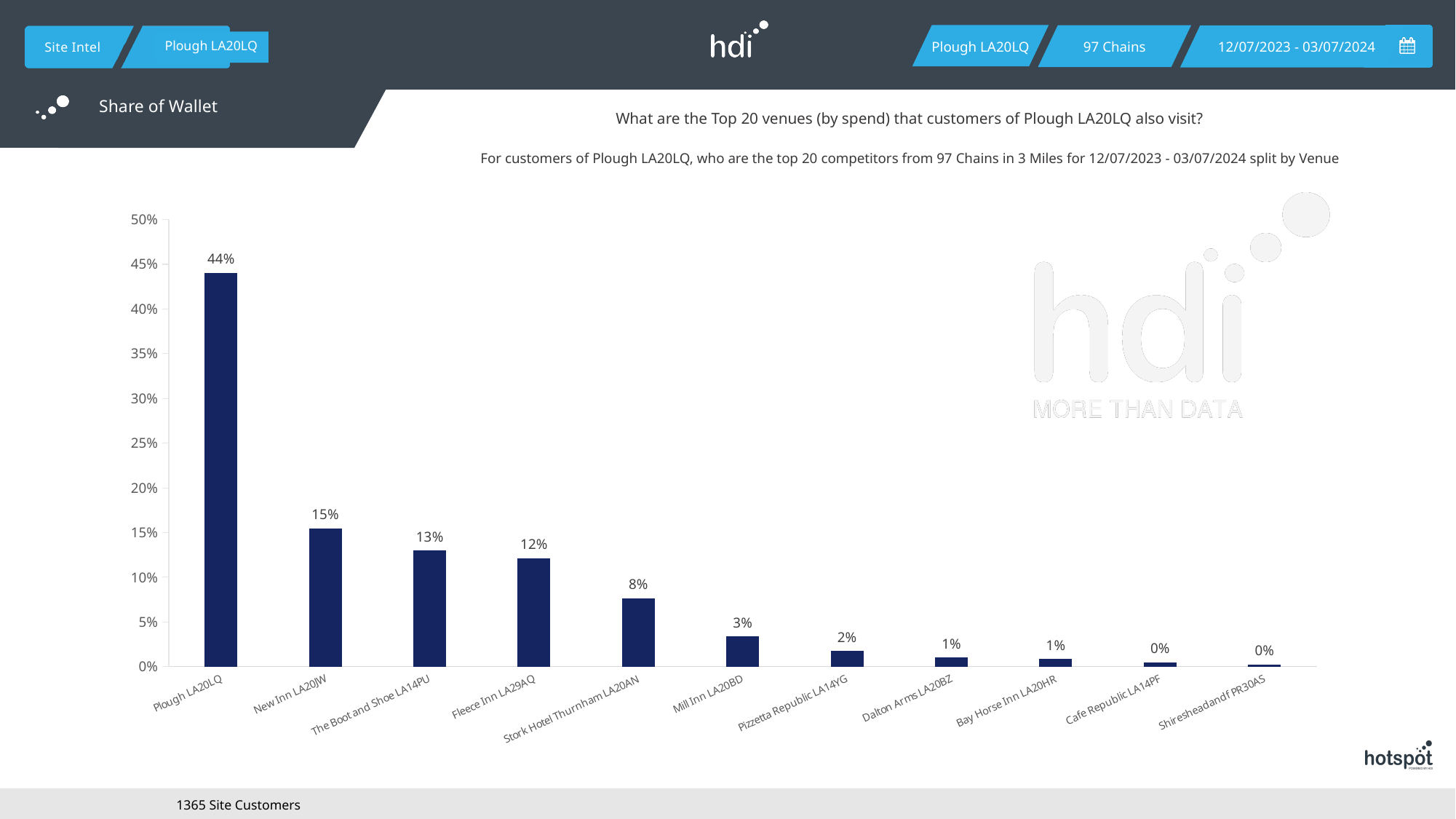
What is the difference between the values for Plough LA20LQ and Fleece Inn LA29AQ? 32% Which venue has the highest value? Plough LA20LQ What is the difference between the values for New Inn LA20JW and The Boot and Shoe LA14PU? 2% What is the value for Mill Inn LA20BD? 3% What is the value for New Inn LA20JW? 15% Do the values rise or fall from left to right along the x axis? Fall How many venues are shown on the chart? 11 What is the value for Plough LA20LQ? 44% What kind of chart is shown on the slide? Bar chart What is the value for Stork Hotel Thurnham LA20AN? 8% Which is larger, the value for Fleece Inn LA29AQ or the value for Stork Hotel Thurnham LA20AN? Fleece Inn LA29AQ Is the value for Plough LA20LQ greater or less than 40%? greater